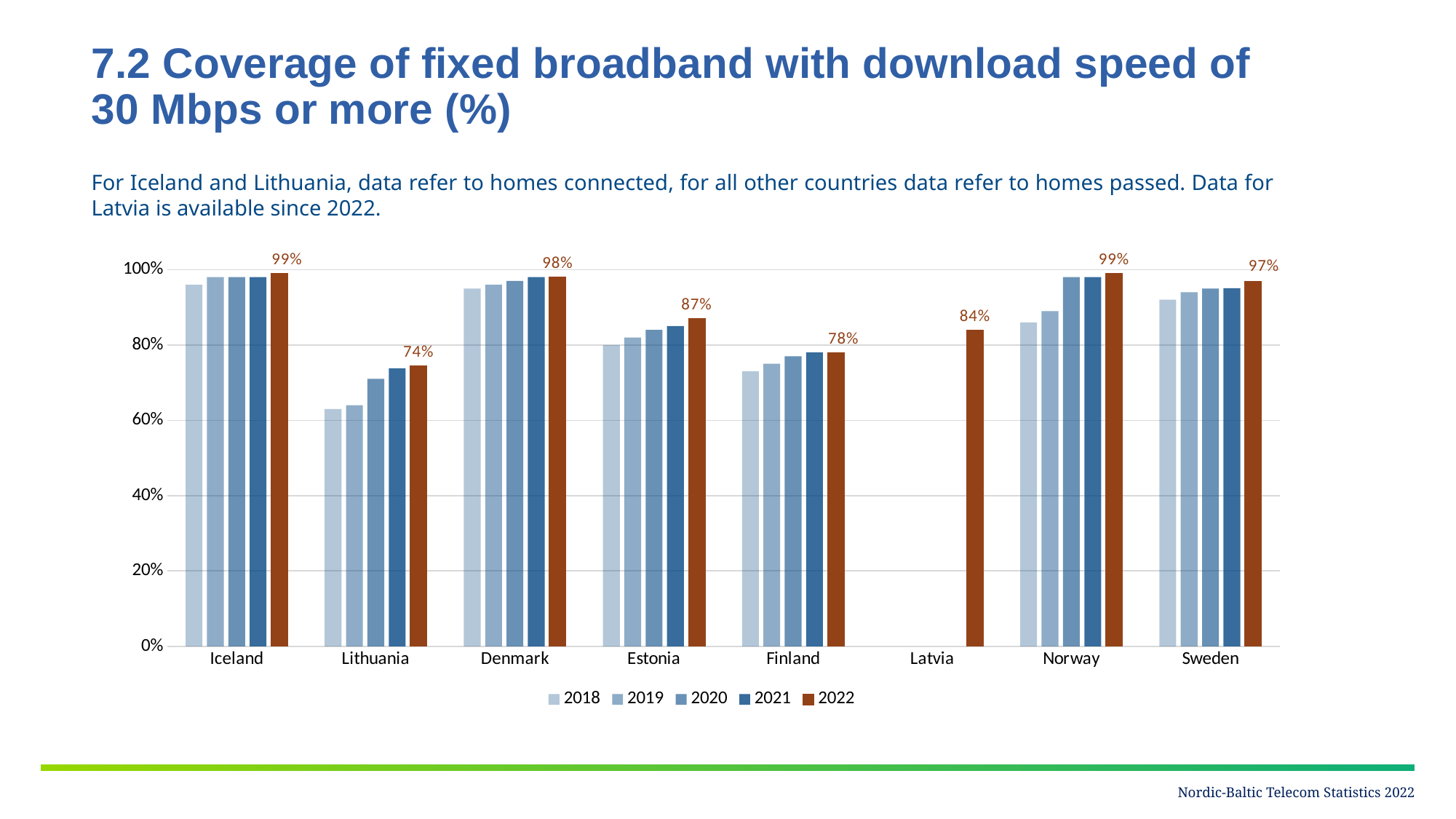
Do the values for Lithuania rise or fall from 2018 to 2022? rise What is the difference between the 2022 values for Norway and Finland? 21% How many series does the legend list? 5 What is the 2022 value for Latvia? 84% Which is larger, the 2022 value for Sweden or the 2022 value for Estonia? Sweden What is the 2022 value for Lithuania? 74% What is the 2022 value for Estonia? 87% Which country has the lowest 2022 value? Lithuania What kind of chart is shown on the slide? bar chart Is the 2018 value for Lithuania greater or less than 80%? less How many countries are shown on the x axis? 8 Is the 2018 value for Iceland greater or less than 80%? greater